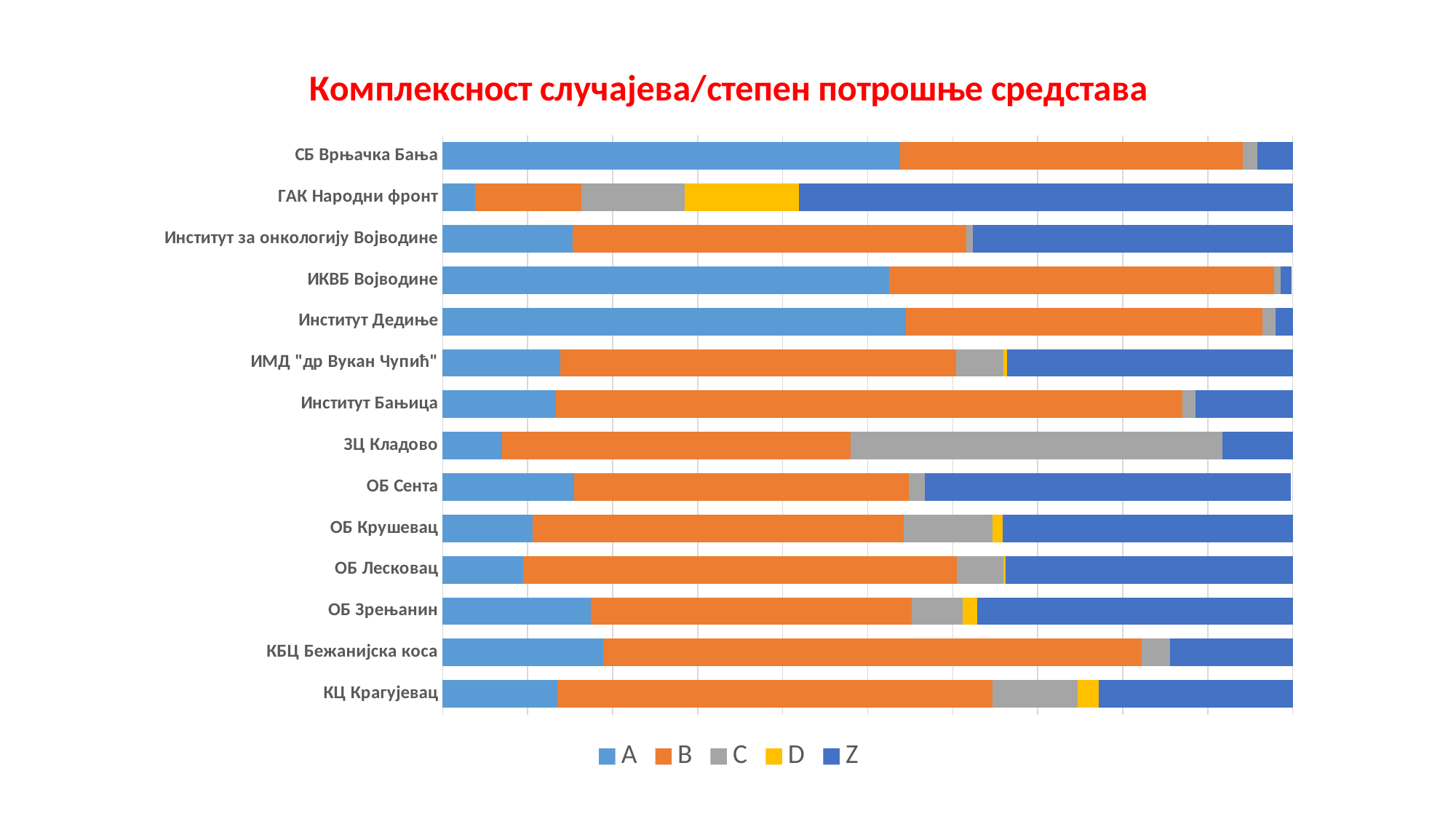
What is the title of the chart? Комплексност случајева/степен потрошње средстава Which institution has the largest D (yellow) segment in its bar? ГАК Народни фронт How many institutions (categories) are listed on the chart? 14 Which series are listed in the legend? A, B, C, D, Z Which institution has the largest C (grey) segment in its bar? ЗЦ Кладово Is the A segment larger for СБ Врњачка Бања or for ГАК Народни фронт? СБ Врњачка Бања What kind of chart is shown on the slide? Stacked bar chart Which institution has the smallest A (light blue) segment in its bar? ГАК Народни фронт Which institution has the smallest Z (dark blue) segment in its bar? ИКВБ Војводине Which institution has the largest Z (dark blue) segment in its bar? ГАК Народни фронт How many series does the legend list? 5 Is the Z segment larger for ОБ Сента or for Институт Бањица? ОБ Сента